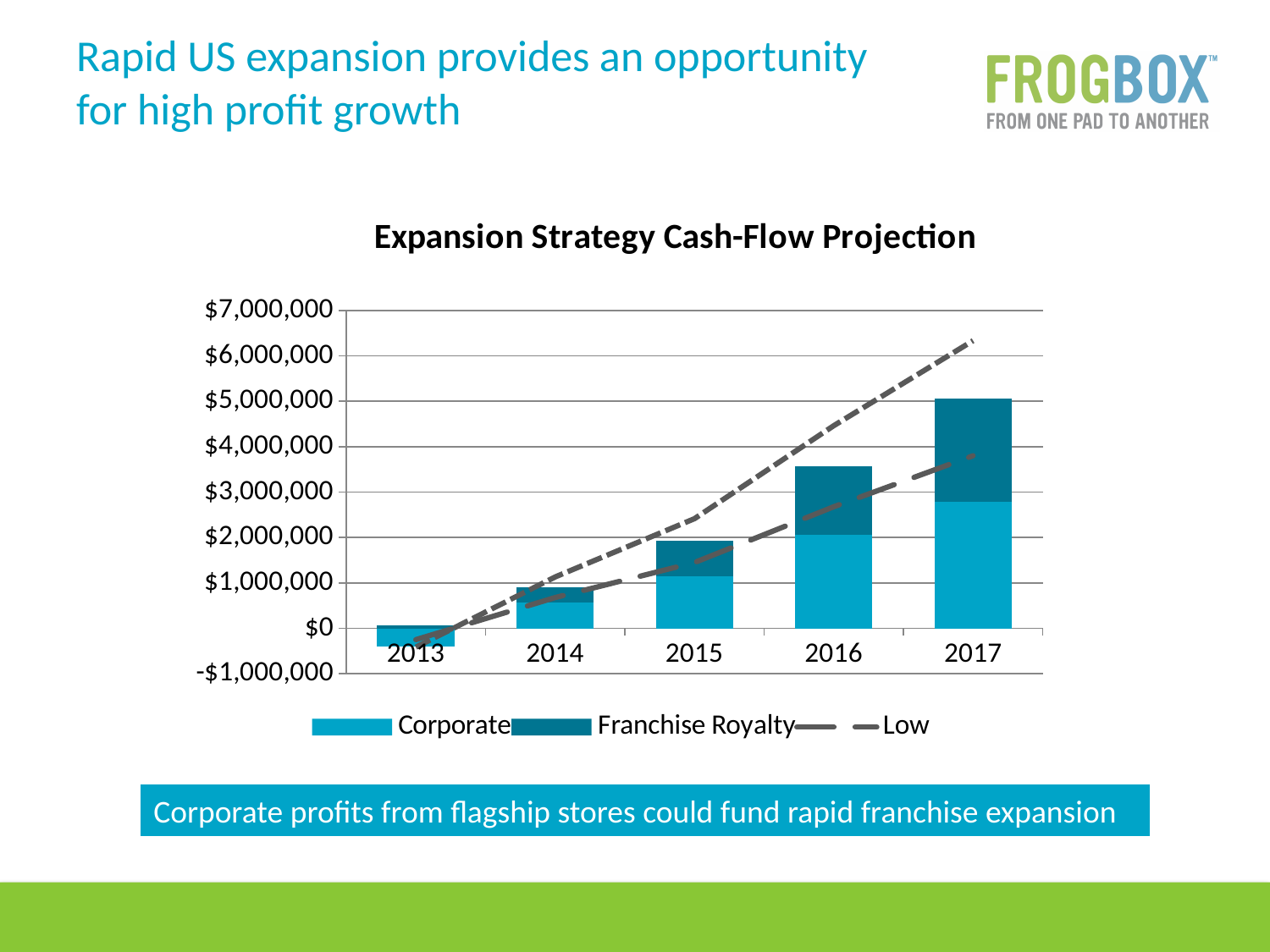
Is the Corporate value for 2014 greater or less than $1,000,000? less Which year has the tallest stacked bar in the chart? 2017 Is the Corporate value for 2013 greater or less than $0? less Is the Corporate value for 2017 greater or less than $2,000,000? greater Which year has the lowest stacked bar in the chart? 2013 What kind of chart is used to show the Corporate and Franchise Royalty values? Stacked bar chart Which series is shown in the lighter blue colour at the bottom of each stacked bar? Corporate Do the stacked bar totals rise or fall from 2013 to 2017? Rise How many years are shown on the x axis of the chart? 5 Which year has the larger Corporate value, 2016 or 2017? 2017 What is the title of the chart? Expansion Strategy Cash-Flow Projection